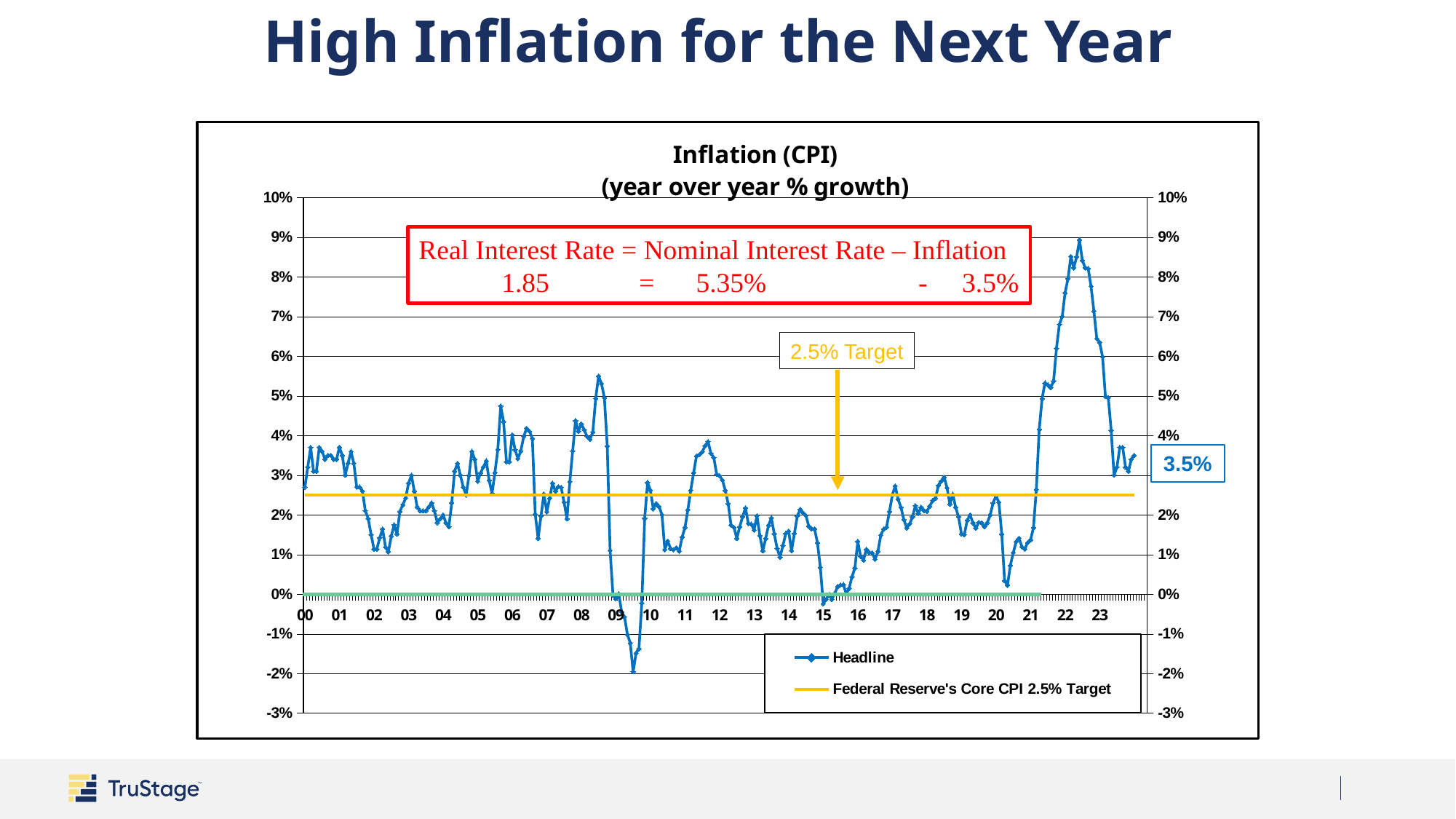
In which year on the x axis does the Headline series reach its highest point? 22 What is the title of the chart? Inflation (CPI) (year over year % growth) How many series does the chart legend list? 2 In which year on the x axis does the Headline series reach its lowest point? 09 What is the most recent Headline inflation value labelled on the chart? 3.5% Which is higher: the Headline peak around 2008 or the Headline peak around 2022? the peak around 2022 Does the Headline series rise or fall from its 2022 peak to the end of the chart? fall What are the two series named in the chart legend? Headline; Federal Reserve's Core CPI 2.5% Target Is the lowest Headline inflation value around 2009 greater or less than -1%? less What kind of chart is shown on the slide? line chart Is the peak Headline inflation value around 2022 greater or less than 8%? greater At what level is the Federal Reserve's Core CPI target line drawn? 2.5%